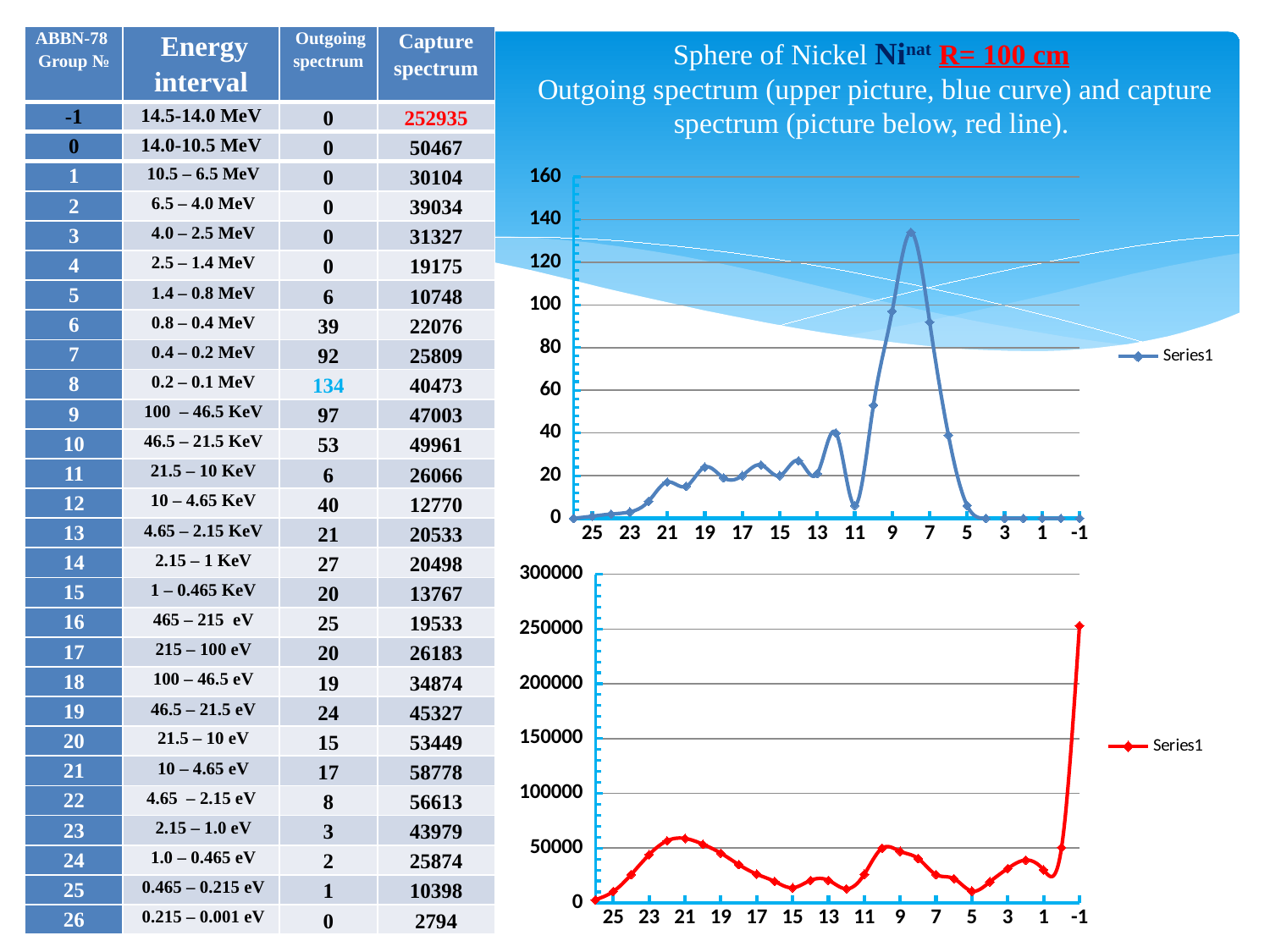
What colour is the curve in the lower (capture spectrum) chart? red In the upper chart, is the value at group 8 greater or less than 120? greater What type of chart is the lower chart (capture spectrum)? line chart What type of chart is the upper chart (outgoing spectrum)? line chart In the upper chart, at which group number does the curve reach its highest value? 8 In the lower chart, do the values rise or fall going from group 3 to group -1? rise In the upper chart, which has the larger value, group 13 or group 11? group 13 In the lower chart, at which group number does the curve reach its highest value? -1 In the upper chart, is the value at group 21 greater or less than 40? less In the lower chart, is the value at group -1 greater or less than 200000? greater What is the legend entry shown for the lower chart? Series1 In the upper chart, how many series does the legend list? 1